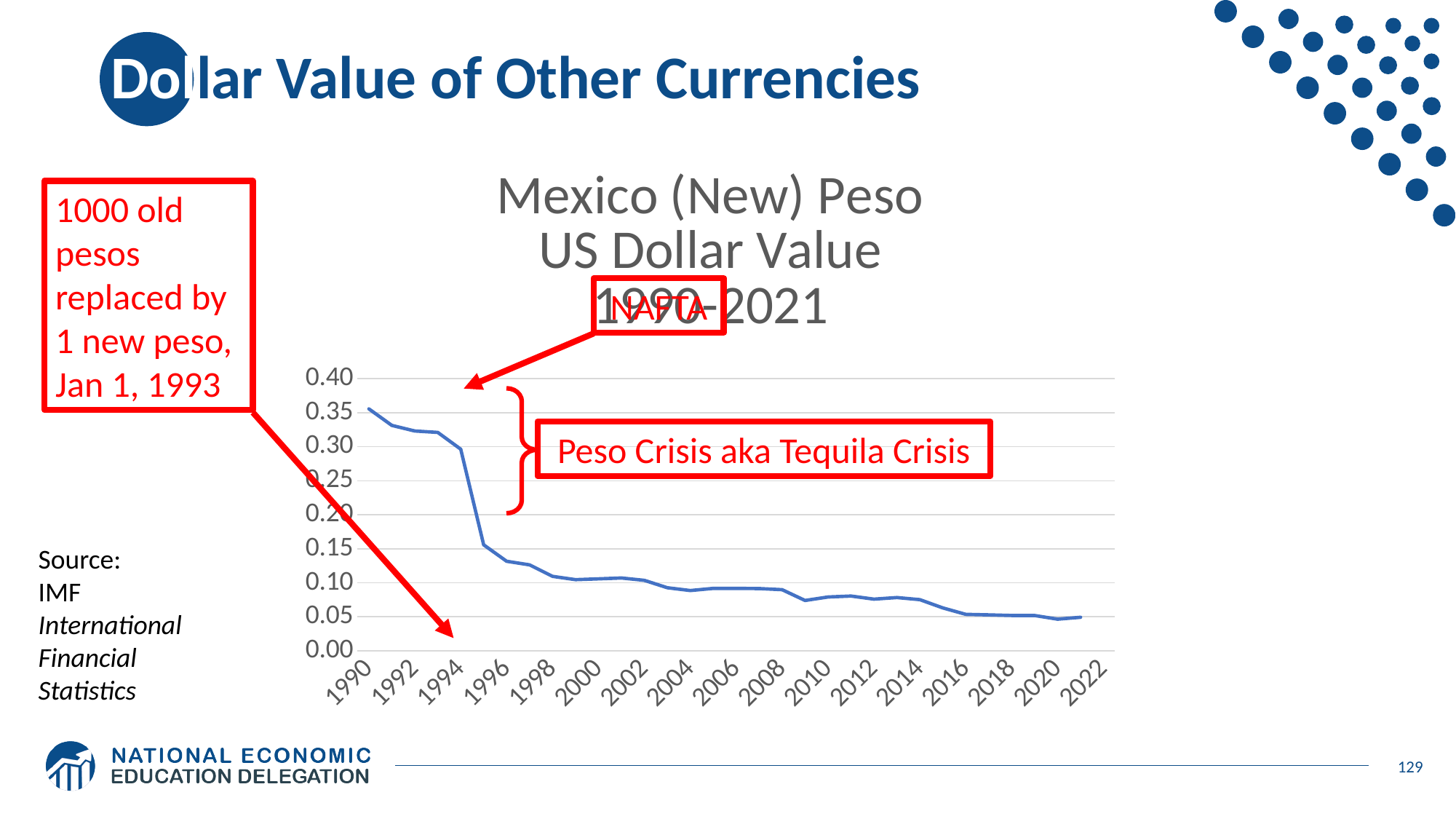
Is the value for 1990 greater or less than 0.30? greater Does the US dollar value of the Mexican peso rise or fall from 1990 to 2021? fall Is the value for 2004 greater or less than 0.05? greater What kind of chart is shown on the slide? line chart Is the value for 1996 greater or less than 0.15? less What is the title of the chart? Mexico (New) Peso US Dollar Value 1990-2021 What crisis does the red annotation label the sharp drop in the mid-1990s as? Peso Crisis aka Tequila Crisis In which year shown on the x axis is the peso's US dollar value highest? 1990 Which year has the larger value, 1994 or 1996? 1994 How many year labels are shown on the x axis? 17